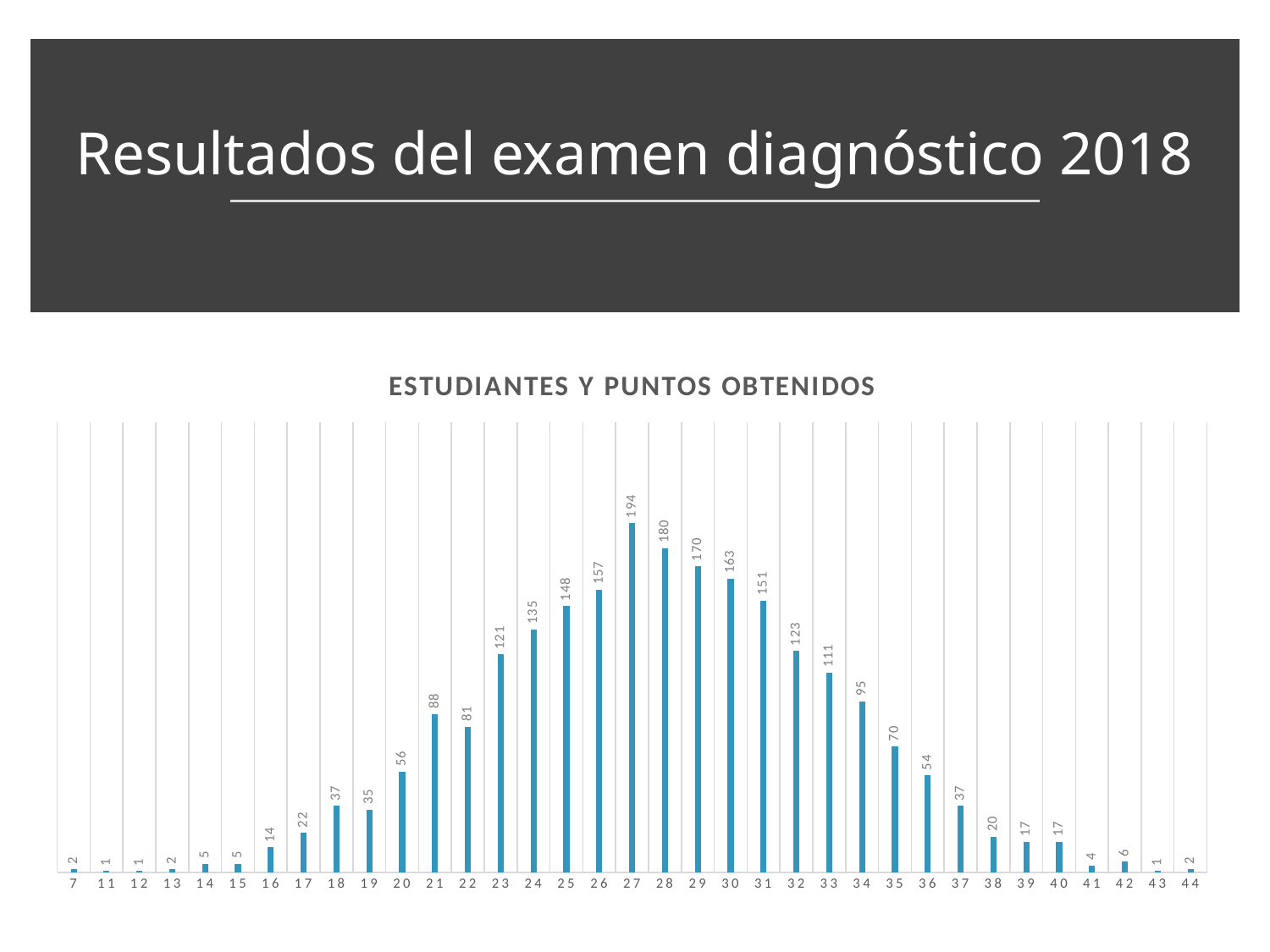
Which is larger, the value for 18 points or the value for 19 points? 18 points Do the values rise or fall from 27 points to 44 points along the x axis? fall Which score has the highest number of students? 27 Which is larger, the value for 23 points or the value for 32 points? 32 points What is the value for 21 points? 88 What is the difference between the values for 27 and 20 points? 138 How many students obtained 27 points? 194 What is the difference between the values for 28 and 29 points? 10 What kind of chart is shown on the slide? bar chart What is the title of the chart? ESTUDIANTES Y PUNTOS OBTENIDOS What is the value for 35 points? 70 How many score categories are shown on the x axis? 35